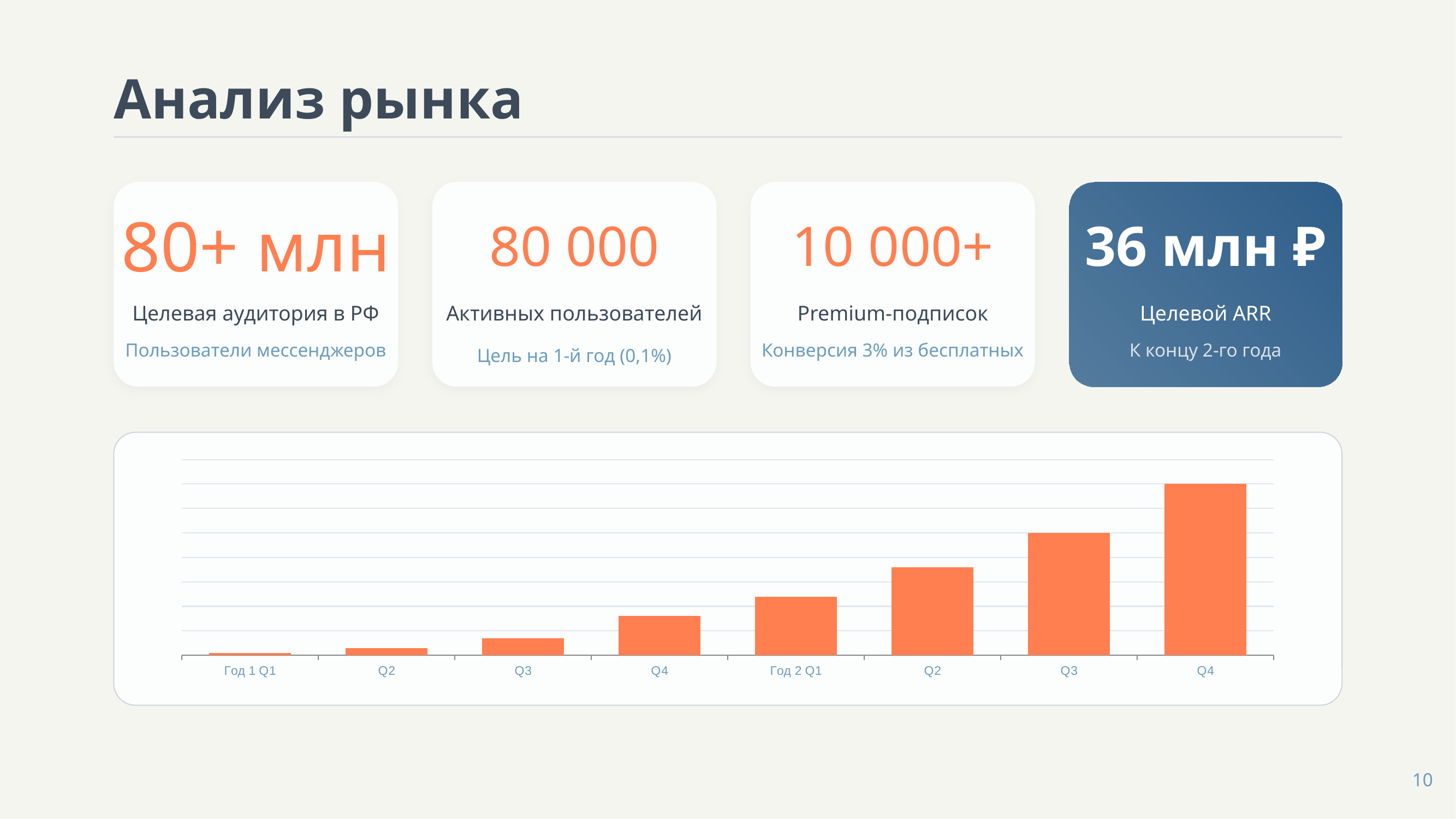
What colour are the bars in the chart? orange What is the label of the first category on the x axis of the chart? Год 1 Q1 Which is larger: the bar for Год 1 Q3 or the bar for Год 2 Q3? Год 2 Q3 Which is larger: the bar for Год 2 Q1 or the bar for Год 1 Q4? Год 2 Q1 Do the bar values rise or fall from Год 1 Q1 to Год 2 Q4? rise Which category has the lowest bar in the chart? Год 1 Q1 What kind of chart is shown at the bottom of the slide? bar chart Which is larger: the bar for Год 2 Q2 or the bar for Год 2 Q4? Год 2 Q4 How many bars (categories) does the chart show? 8 Which category has the highest bar in the chart? Год 2 Q4